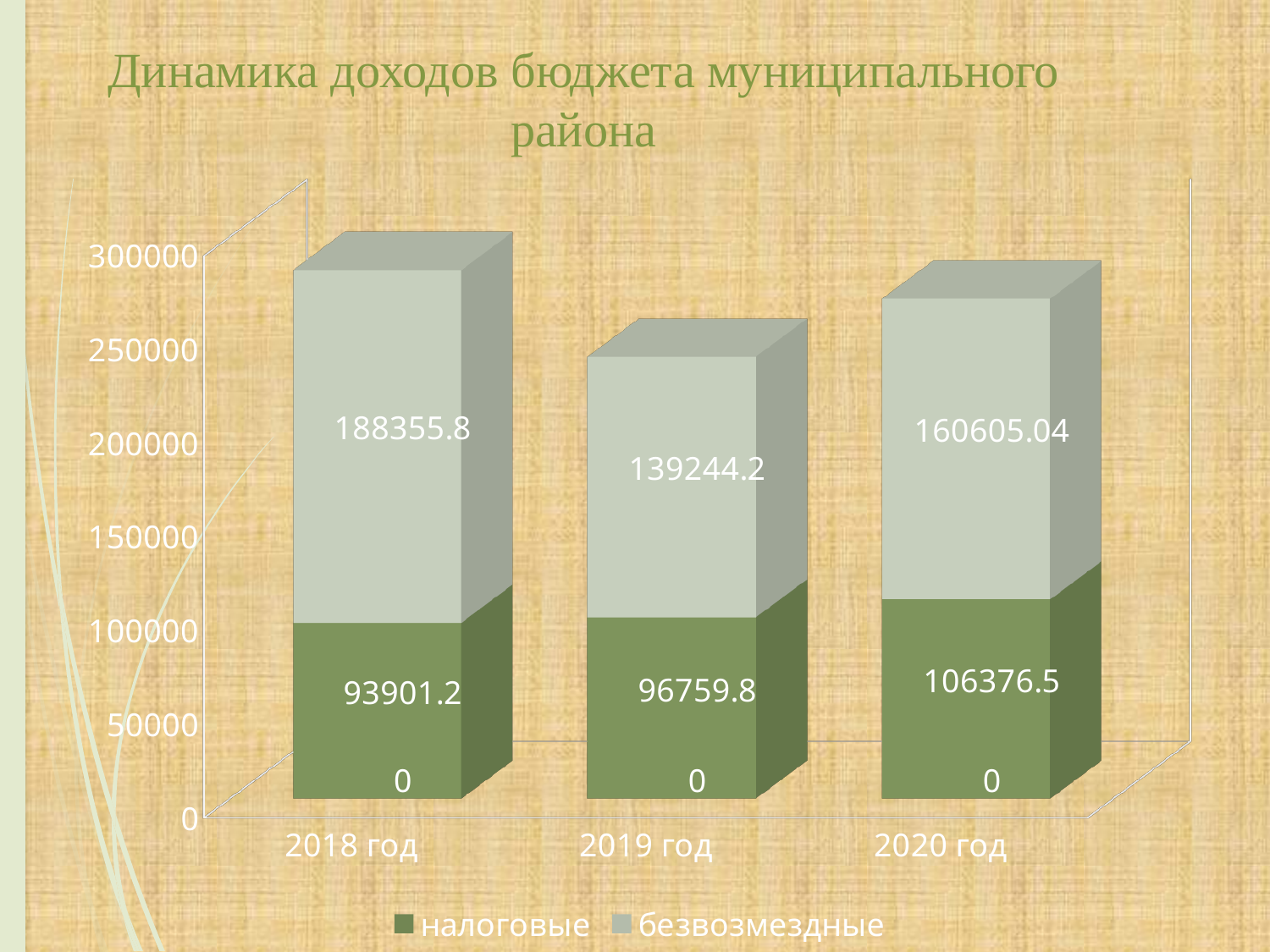
Which is larger: безвозмездные for 2018 год or безвозмездные for 2020 год? 2018 год Which year has the lowest value for безвозмездные? 2019 год What kind of chart is shown on the slide? Stacked bar chart What is the total of the stacked bar for 2019 год? 236004.0 How many series does the legend list? 2 How many years are shown on the x axis? 3 Do the налоговые values rise or fall from 2018 год to 2020 год? Rise What is the value of налоговые for 2018 год? 93901.2 What is the difference between the налоговые values for 2020 год and 2018 год? 12475.3 What is the value of безвозмездные for 2020 год? 160605.04 Which year has the highest value for налоговые? 2020 год What is the value of безвозмездные for 2019 год? 139244.2